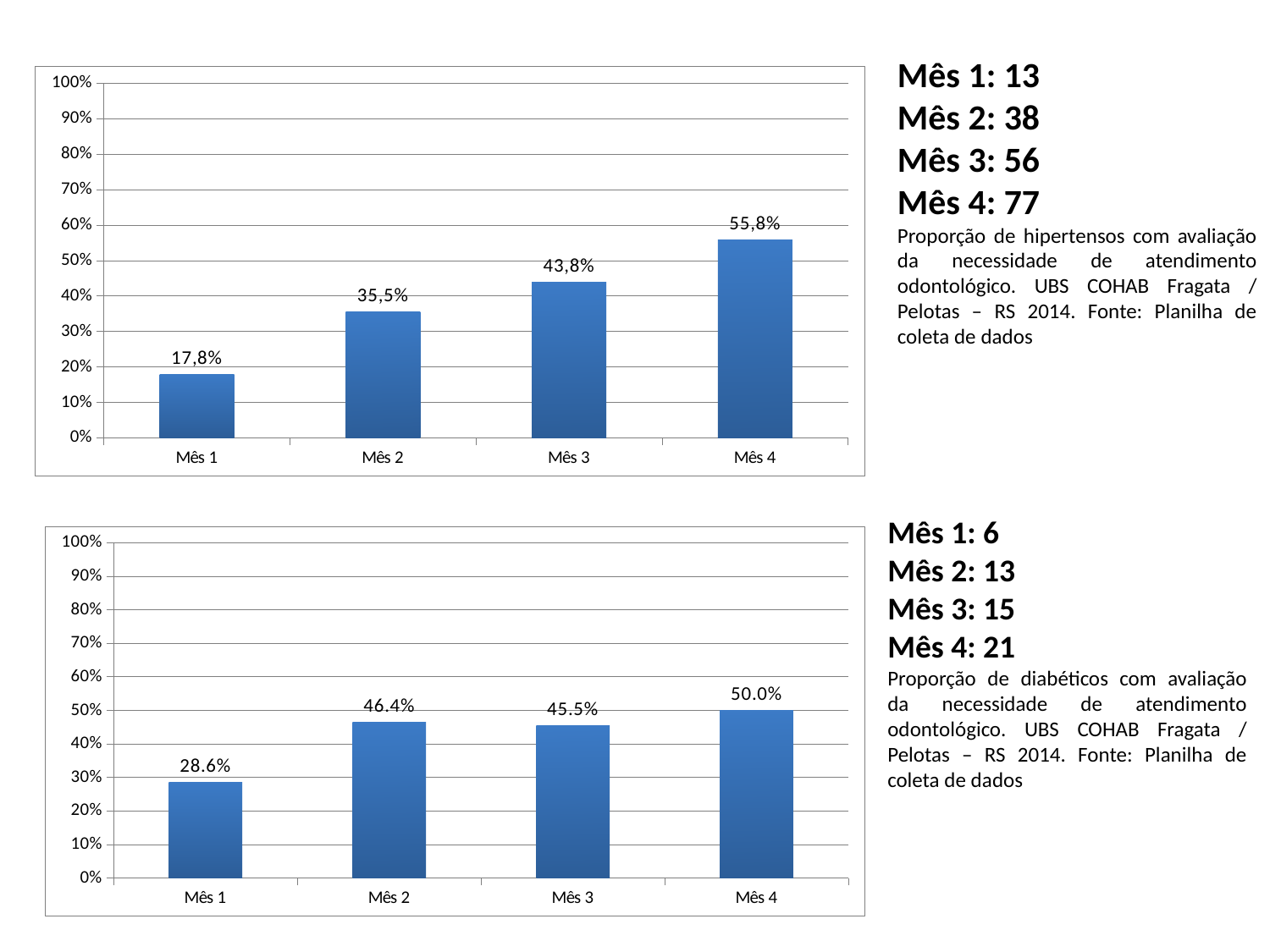
In the top chart, do the values rise or fall from Mês 1 to Mês 4? rise In the bottom chart, what is the value for Mês 3? 45.5% In the top chart, which month has the lowest value? Mês 1 In the top chart, which month has the highest value? Mês 4 In the bottom chart, what is the value for Mês 2? 46.4% What kind of chart is the bottom chart? bar chart In the bottom chart, which month has the highest value? Mês 4 In the bottom chart, which month has the lowest value? Mês 1 In the top chart, what is the value for Mês 1? 17,8% In the top chart, what is the difference between the values for Mês 4 and Mês 3? 12 percentage points In the top chart, what is the value for Mês 4? 55,8% In the bottom chart, how many months are shown on the x axis? 4